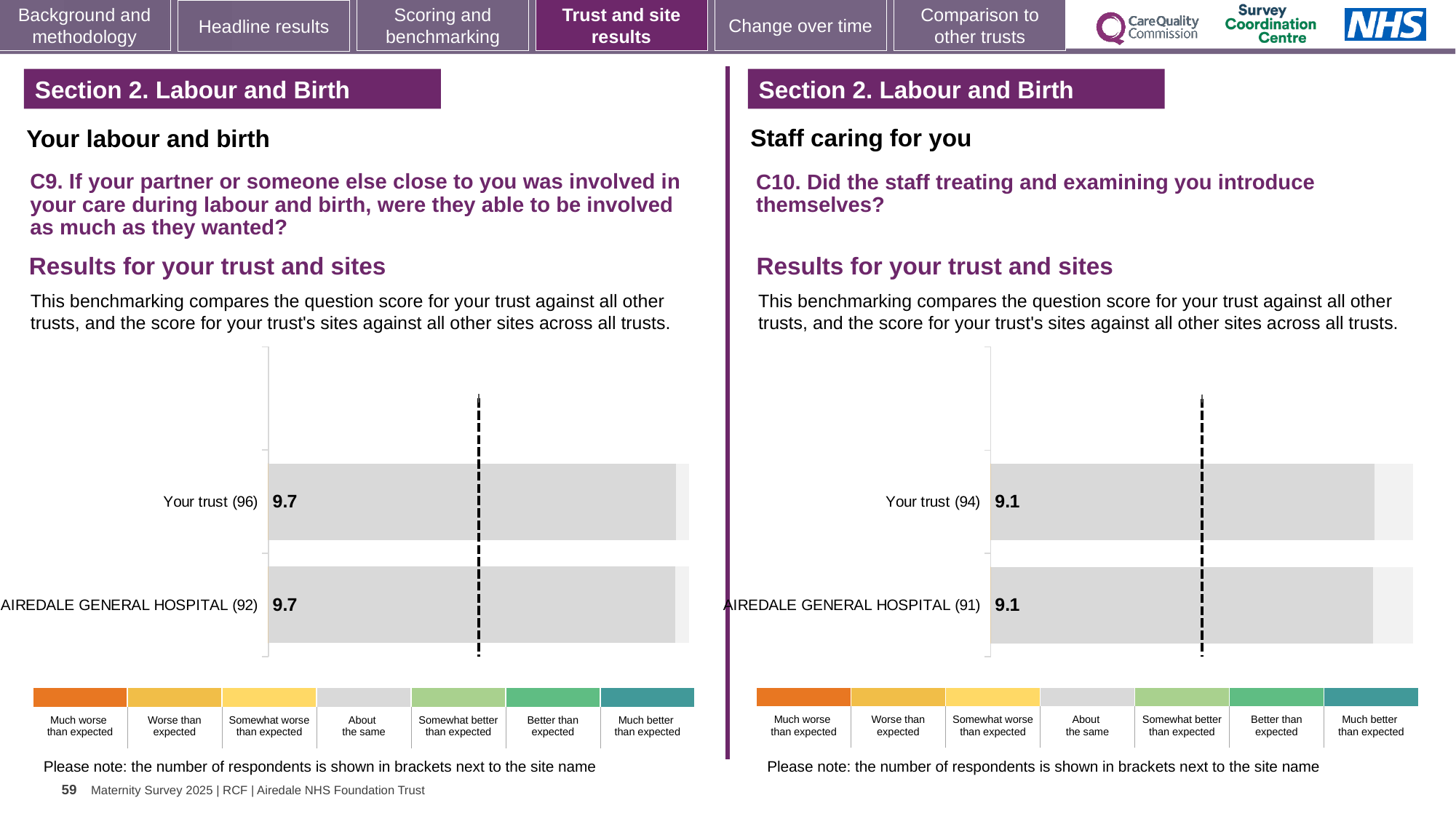
How many bars are plotted in the C10 chart on the right? 2 Is the Your trust score in the C9 chart on the left larger or smaller than the Your trust score in the C10 chart on the right? Larger In the C9 chart on the left, what is the score for Your trust? 9.7 What type of chart is used in the C9 chart on the left? Bar chart In the C10 chart on the right, how many respondents are shown in brackets for Airedale General Hospital? 91 In the C9 chart on the left, what is the difference between the Your trust score and the Airedale General Hospital score? 0.0 In the C10 chart on the right, what is the score for Airedale General Hospital? 9.1 In the C10 chart on the right, what is the score for Your trust? 9.1 In the C10 chart on the right, what is the difference between the Your trust score and the Airedale General Hospital score? 0.0 In the C9 chart on the left, what is the score for Airedale General Hospital? 9.7 How many bars are plotted in the C9 chart on the left? 2 In the C9 chart on the left, how many respondents are shown in brackets for Your trust? 96